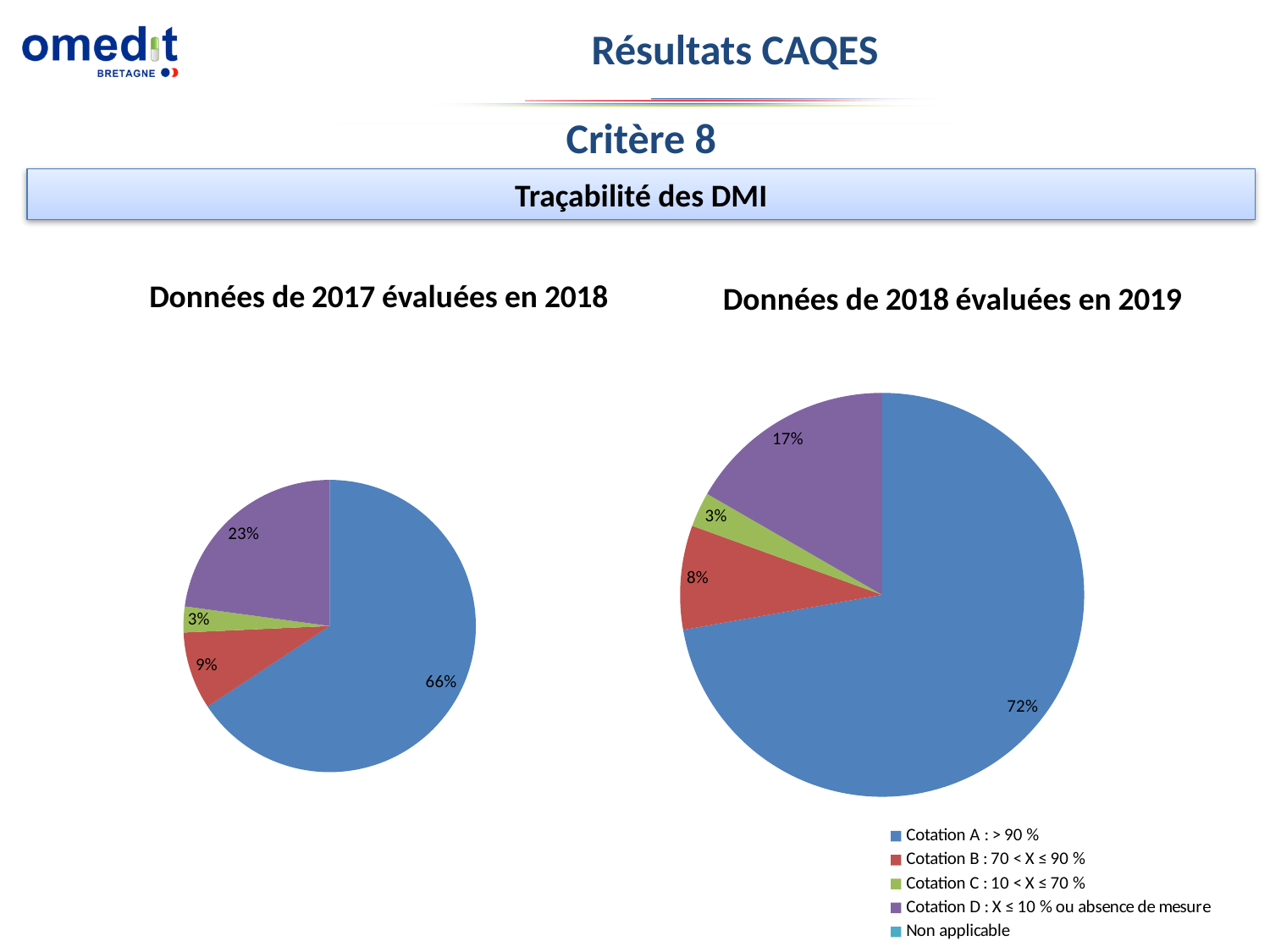
In the chart titled "Données de 2017 évaluées en 2018", which category has the largest slice? Cotation A : > 90 % What kind of chart is used for "Données de 2018 évaluées en 2019"? Pie chart In the chart titled "Données de 2017 évaluées en 2018", what is the difference between the Cotation D slice and the Cotation B slice? 14% In the chart titled "Données de 2018 évaluées en 2019", which category has the smallest slice? Cotation C : 10 < X ≤ 70 % In the chart titled "Données de 2017 évaluées en 2018", what is the value for Cotation D : X ≤ 10 % ou absence de mesure? 23% How many entries does the legend on the slide list? 5 What is the difference between the Cotation A share in the chart titled "Données de 2018 évaluées en 2019" and the Cotation A share in the chart titled "Données de 2017 évaluées en 2018"? 6% In the chart titled "Données de 2018 évaluées en 2019", what is the value for Cotation B : 70 < X ≤ 90 %? 8% In the chart titled "Données de 2018 évaluées en 2019", what share of the pie is Cotation A : > 90 %? 72% Which chart has the larger Cotation D slice, "Données de 2017 évaluées en 2018" or "Données de 2018 évaluées en 2019"? Données de 2017 évaluées en 2018 In the chart titled "Données de 2017 évaluées en 2018", what share of the pie is Cotation A : > 90 %? 66% In the chart titled "Données de 2018 évaluées en 2019", what is the value for Cotation D : X ≤ 10 % ou absence de mesure? 17%